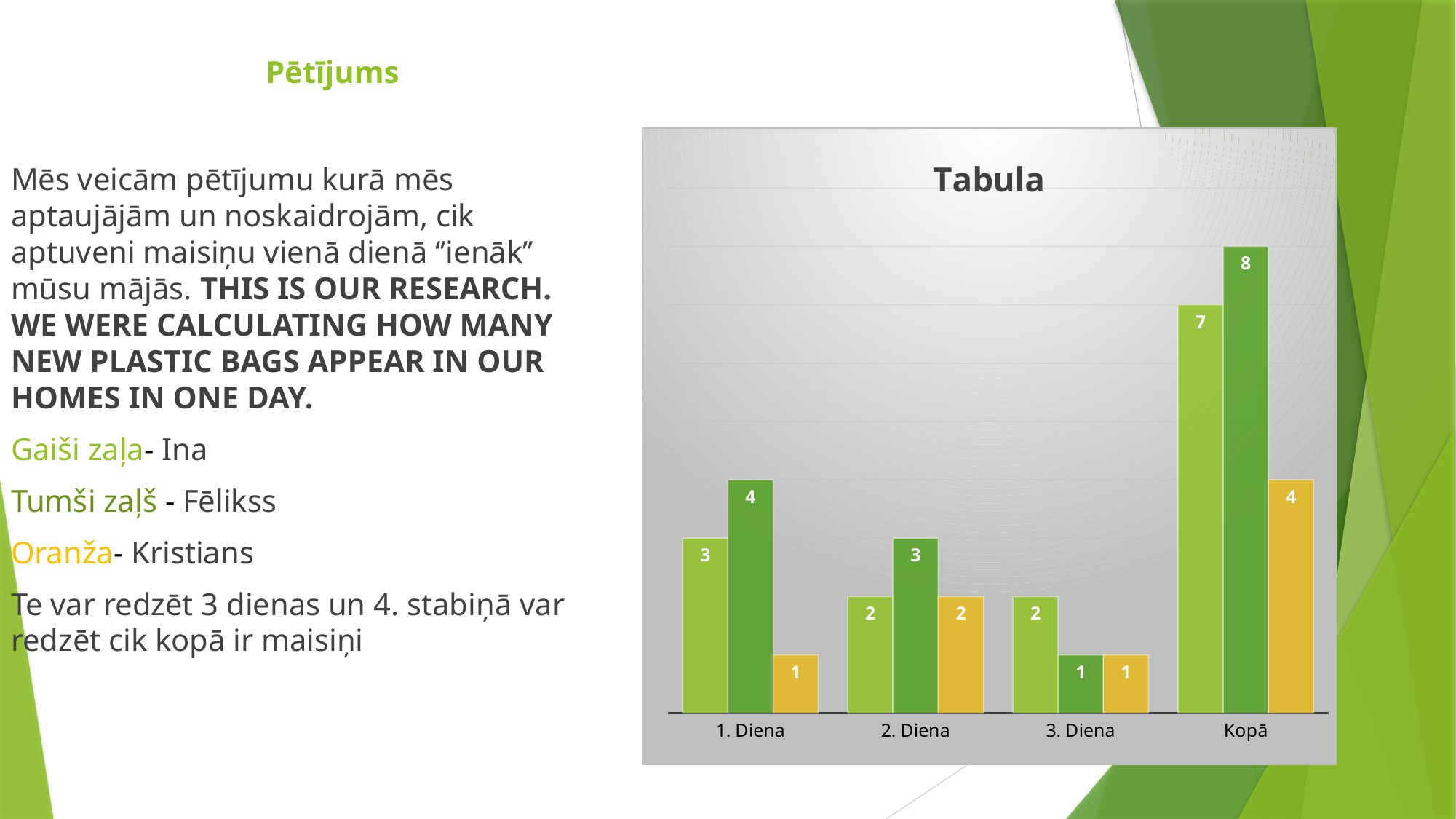
What is the value of the orange bar (Kristians) for 2. Diena? 2 What is the value of the light green bar (Ina) for Kopā? 7 What is the value of the dark green bar (Fēlikss) for 1. Diena? 4 How do the light green (Ina) values change from 1. Diena to 3. Diena? they fall from 3 to 2, then stay at 2 How many categories are shown on the x axis of the chart? 4 What is the difference between the light green bars for 1. Diena and 2. Diena? 1 What is the title of the chart? Tabula What is the difference between the dark green and orange bars for Kopā? 4 Which day has the lowest dark green bar (Fēlikss)? 3. Diena What kind of chart is shown on the slide? bar chart For 1. Diena, which is larger: the light green bar or the orange bar? light green bar Which category has the highest dark green bar? Kopā